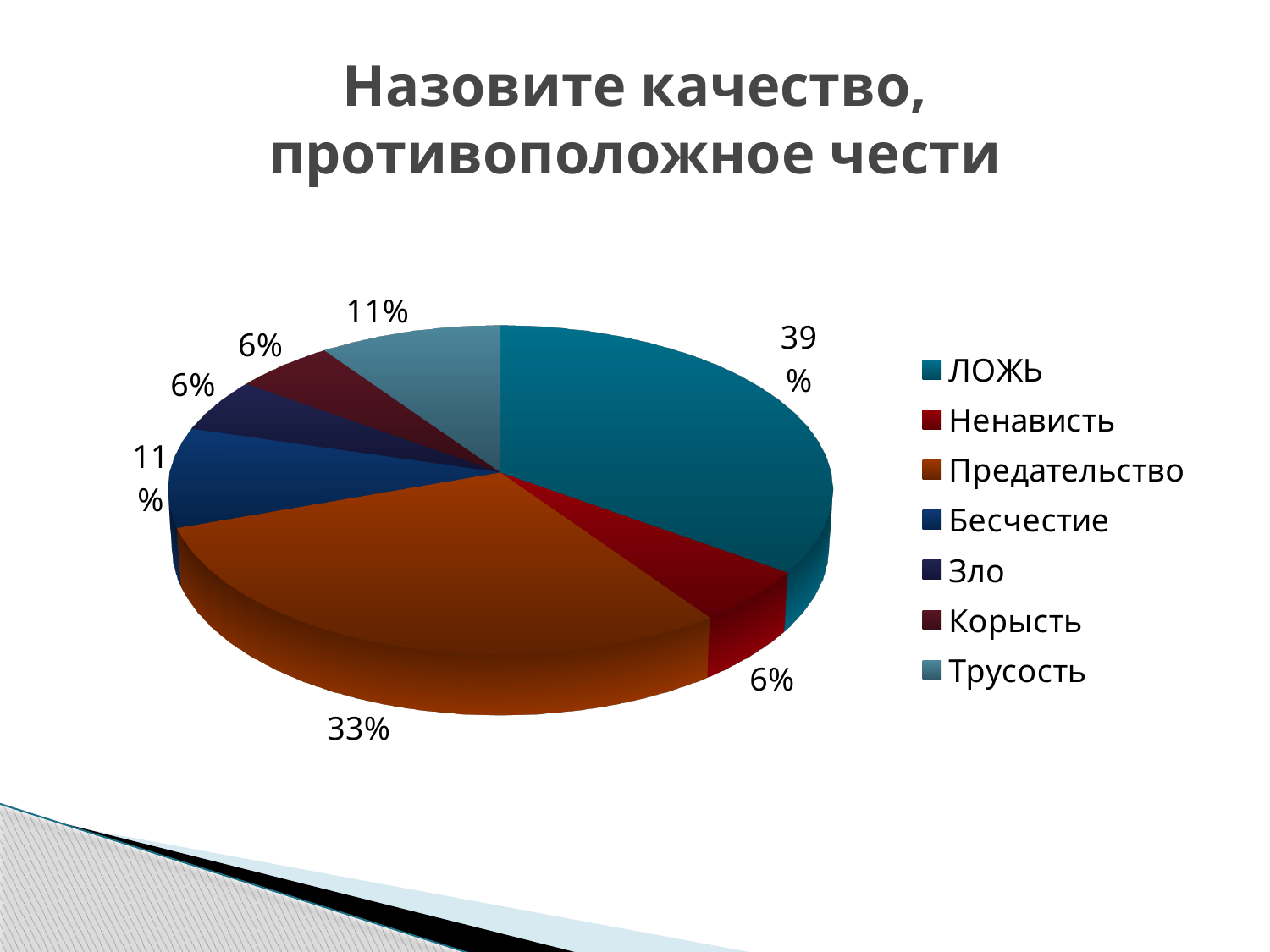
What percentage is shown for Предательство? 33% What type of chart is shown on the slide? pie chart What is the title of the slide? Назовите качество, противоположное чести What percentage is shown for Ненависть? 6% What percentage is shown for Трусость? 11% Which legend entry is listed last? Трусость Which category has the largest share of the pie? ЛОЖЬ Which is larger, the share for Бесчестие or the share for Зло? Бесчестие What is the difference in percentage points between ЛОЖЬ and Предательство? 6 What percentage is shown for ЛОЖЬ? 39% What percentage is shown for Бесчестие? 11% How many categories are shown in the pie chart? 7